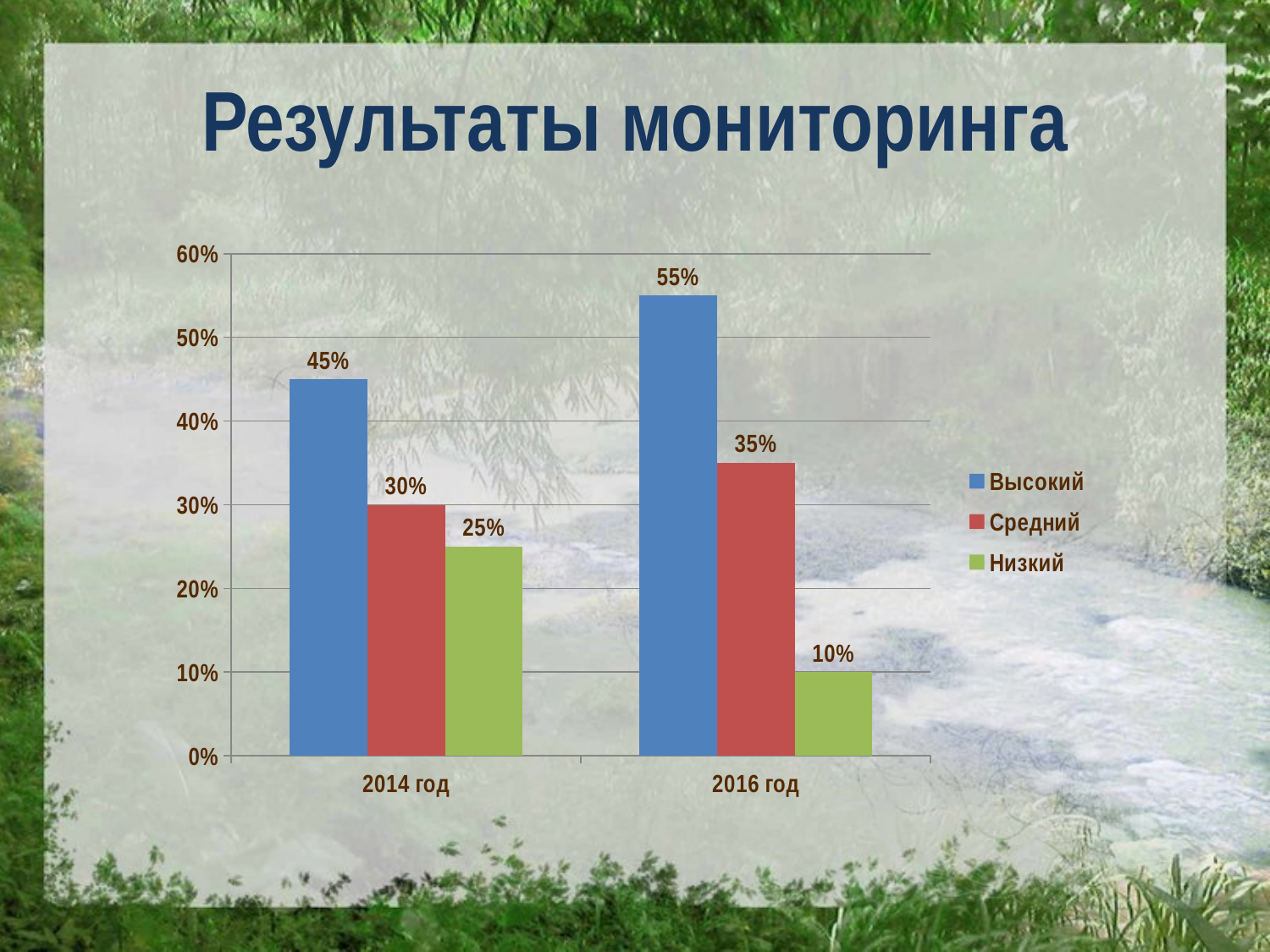
What is the value for Низкий in 2016 год? 10% Does the Низкий series rise or fall from 2014 год to 2016 год? Fall How many series does the legend list? 3 What is the title of the slide? Результаты мониторинга How many categories are shown on the x axis? 2 What kind of chart is shown on the slide? Bar chart What is the value for Средний in 2016 год? 35% What is the difference between the Высокий values for 2016 год and 2014 год? 10% Which series has the highest value in 2016 год? Высокий What is the value for Высокий in 2014 год? 45% Which is larger: Низкий in 2014 год or Низкий in 2016 год? 2014 год Which series has the lowest value in 2014 год? Низкий